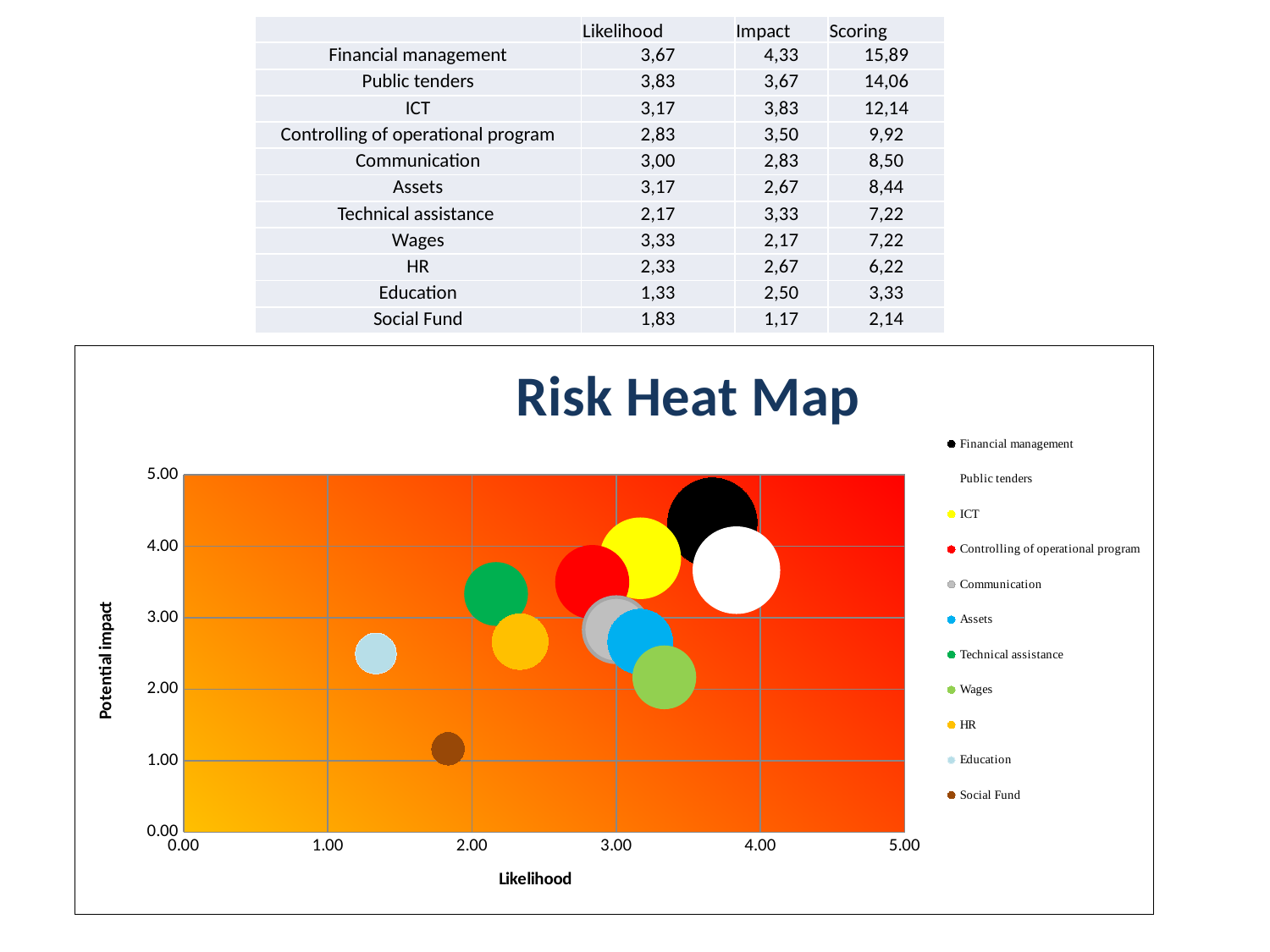
In the Risk Heat Map chart, is the Potential impact value for Social Fund greater or less than 2.00? less In the Risk Heat Map chart, is the Likelihood value for Education greater or less than 2.00? less In the Risk Heat Map chart, is the Potential impact value for Financial management greater or less than 4.00? greater According to the table on the slide, what is the difference in Scoring between Financial management and Social Fund? 13,75 According to the table on the slide, what is the Scoring value for Financial management? 15,89 What is the label of the vertical axis of the Risk Heat Map chart? Potential impact How many series does the legend of the Risk Heat Map chart list? 11 According to the table on the slide, which category has the lowest Scoring? Social Fund What kind of chart is the Risk Heat Map? Bubble chart According to the table on the slide, which has the higher Likelihood, Public tenders or ICT? Public tenders What is the title of the chart on the slide? Risk Heat Map